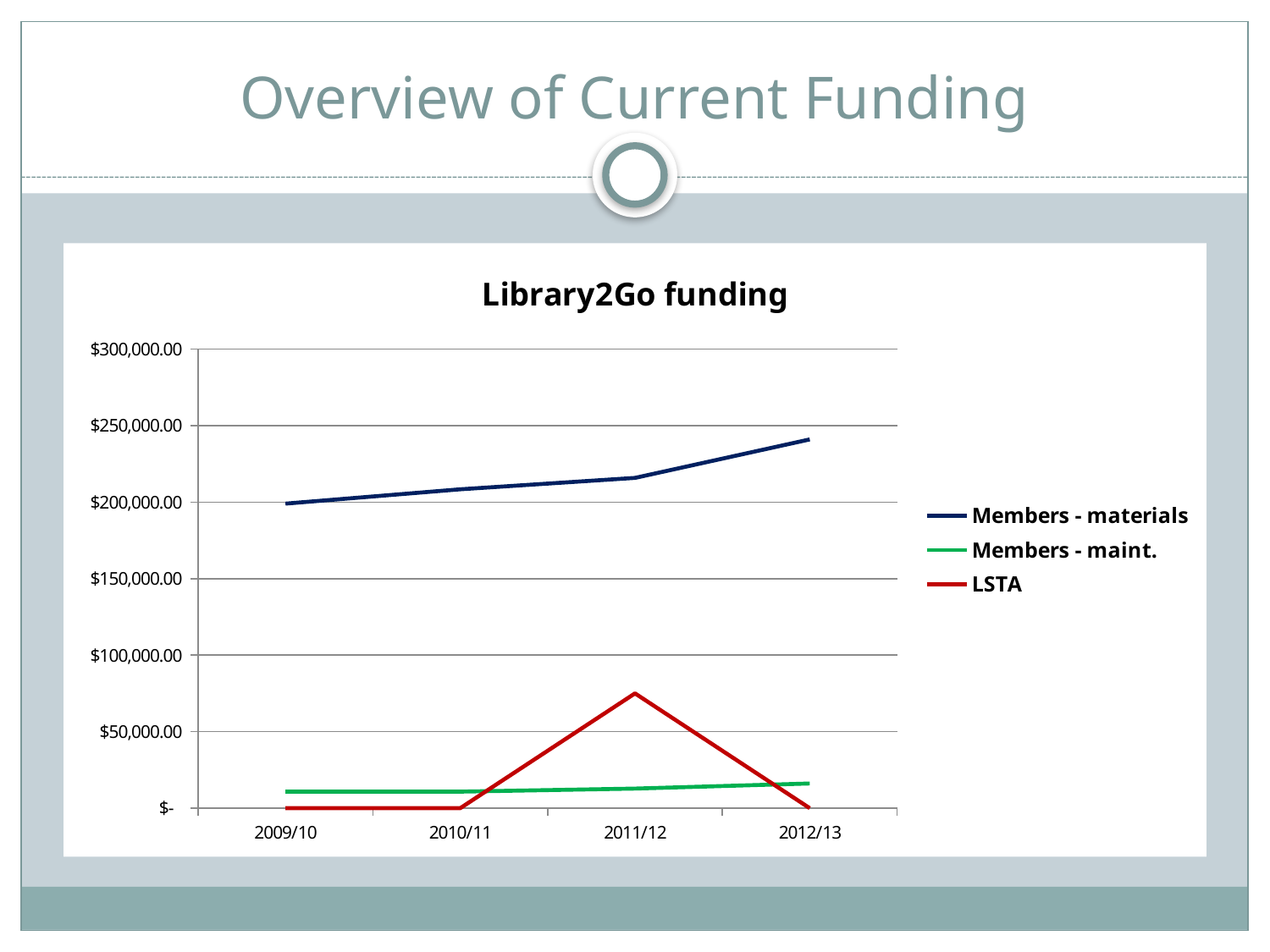
Is the value for LSTA in 2011/12 greater or less than $50,000.00? greater Is the value for Members - materials in 2012/13 greater or less than $250,000.00? less In 2012/13, which is larger: Members - maint. or LSTA? Members - maint. Is the value for Members - maint. in 2009/10 greater or less than $50,000.00? less In which year is Members - materials funding highest? 2012/13 How many years are shown on the x axis? 4 Which series has the highest value in 2011/12? Members - materials What kind of chart is shown on the slide? line chart What is the title of the chart? Library2Go funding How many series does the legend list? 3 In which year is LSTA funding highest? 2011/12 Does the Members - materials line rise or fall from 2009/10 to 2012/13? rise